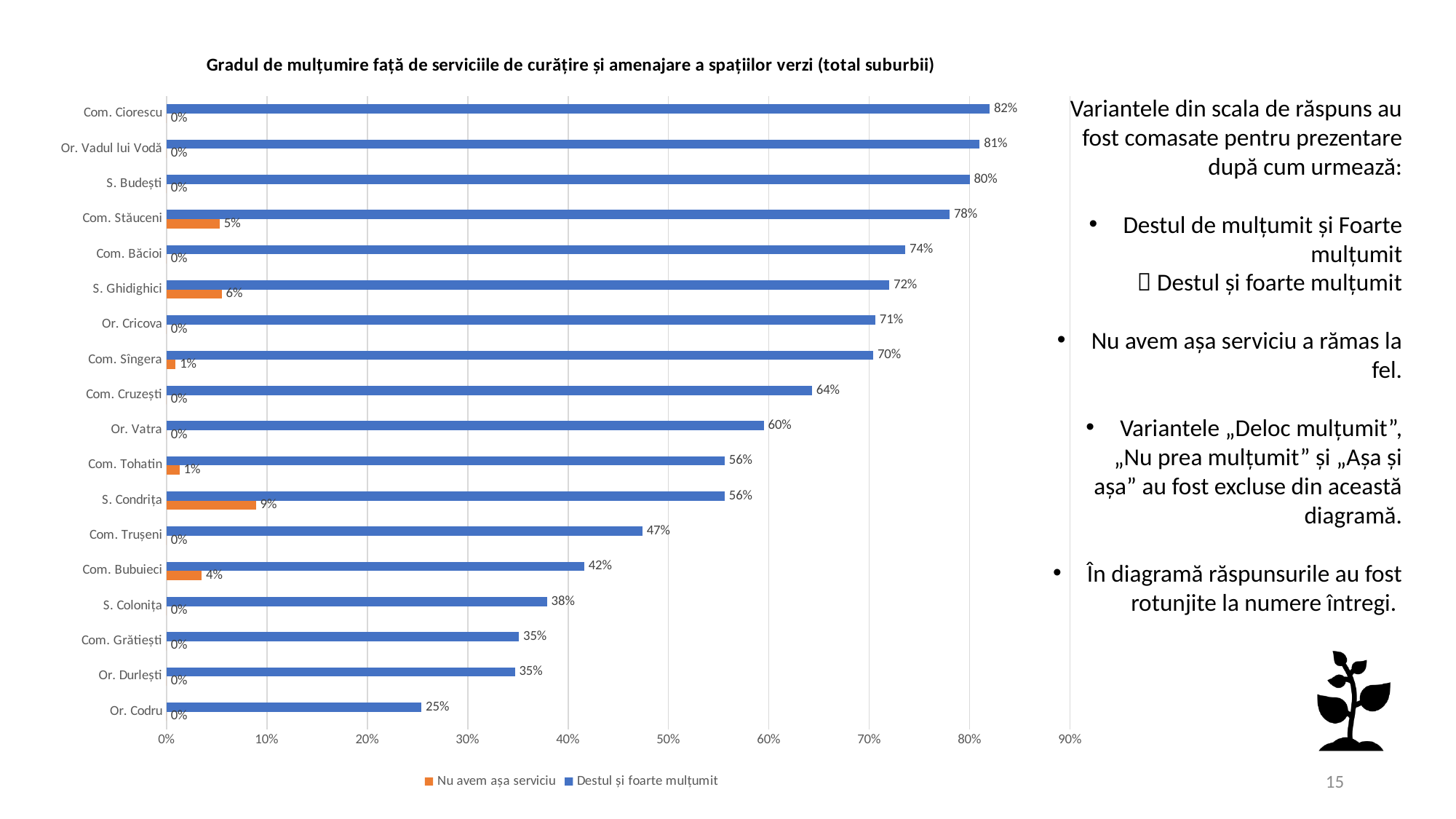
What is the value of "Nu avem așa serviciu" for S. Condrița? 9% What is the value of "Destul și foarte mulțumit" for Or. Codru? 25% What is the difference between the "Destul și foarte mulțumit" values for Com. Ciorescu and Or. Codru? 57% Which category has the lowest value for "Destul și foarte mulțumit"? Or. Codru What kind of chart is shown on the slide? Bar chart What is the value of "Destul și foarte mulțumit" for Com. Ciorescu? 82% Which has a larger "Destul și foarte mulțumit" value, Com. Băcioi or Com. Trușeni? Com. Băcioi Which category has the highest value for "Destul și foarte mulțumit"? Com. Ciorescu What is the value of "Nu avem așa serviciu" for Com. Stăuceni? 5% How many categories (localities) are shown on the chart? 18 How many series does the legend list? 2 Which category has the highest value for "Nu avem așa serviciu"? S. Condrița